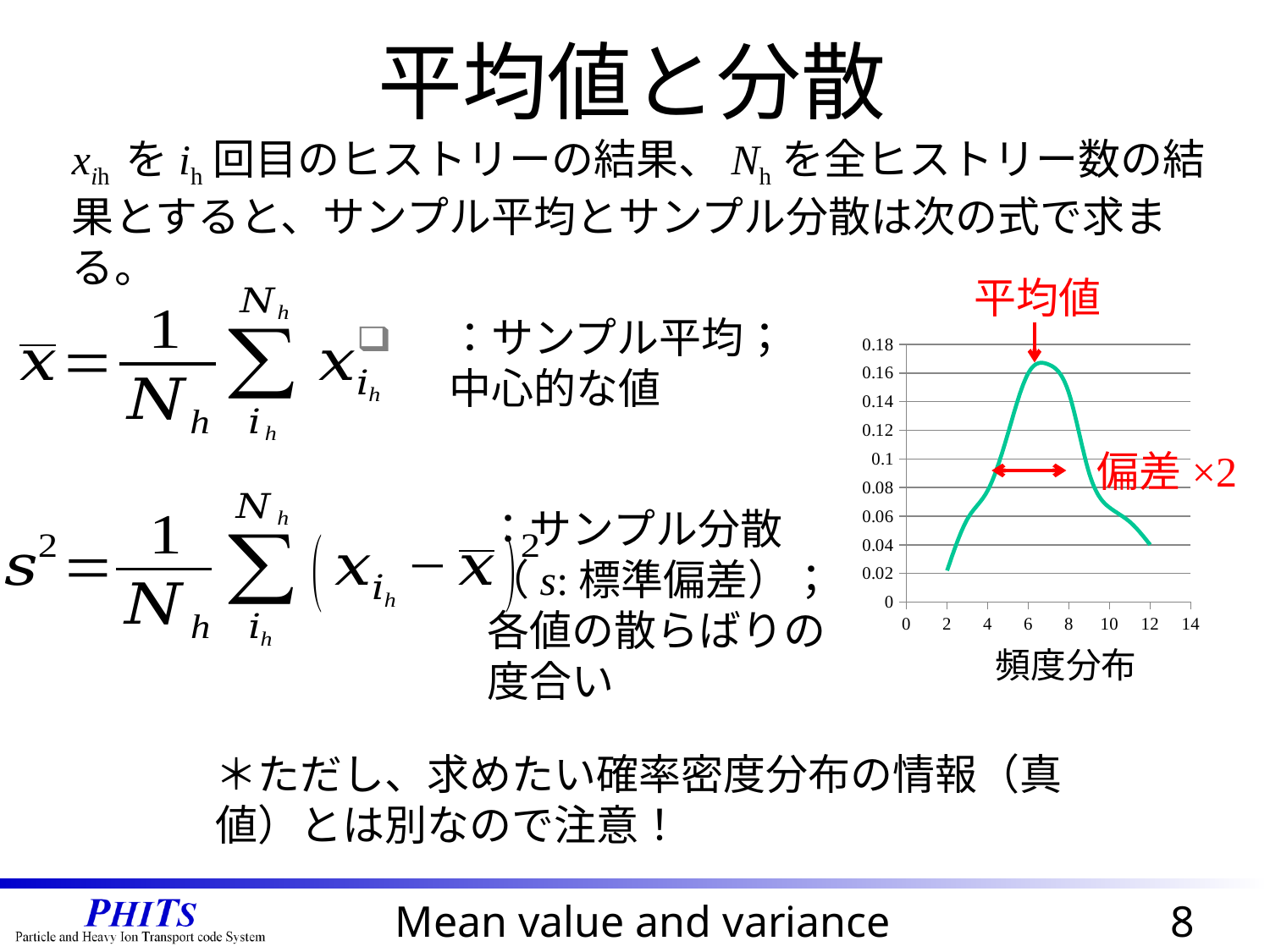
What caption is written below the chart? 頻度分布 Is the value of the curve at x = 8 greater or less than 0.1? greater What kind of chart is shown on the right side of the slide? line chart Is the peak value of the curve in the chart greater or less than 0.14? greater What is the highest tick value shown on the vertical axis of the chart? 0.18 Is the value of the curve at x = 10 greater or less than 0.1? less Does the curve rise or fall between x = 8 and x = 12? fall Does the curve rise or fall between x = 2 and x = 6? rise